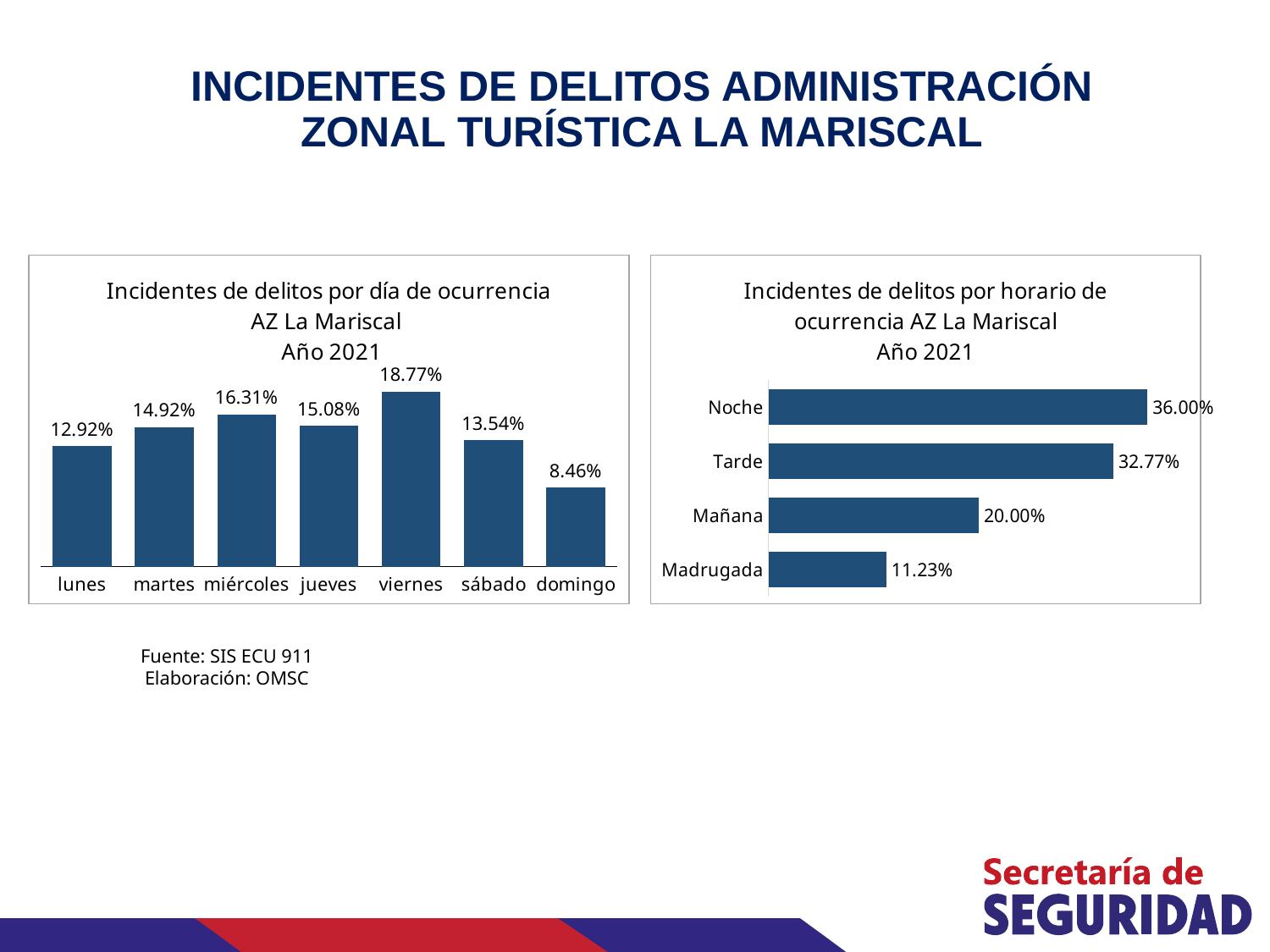
In the right chart (Incidentes de delitos por horario de ocurrencia), which time period has the highest value? Noche What kind of chart is the right chart (Incidentes de delitos por horario de ocurrencia)? bar chart In the left chart (Incidentes de delitos por día de ocurrencia), how many days are shown? 7 In the right chart (Incidentes de delitos por horario de ocurrencia), which time period has the lowest value? Madrugada In the right chart (Incidentes de delitos por horario de ocurrencia), what is the difference between Noche and Mañana? 16.00% In the left chart (Incidentes de delitos por día de ocurrencia), what is the difference between viernes and domingo? 10.31% In the left chart (Incidentes de delitos por día de ocurrencia), what is the value for viernes? 18.77% In the left chart (Incidentes de delitos por día de ocurrencia), which is larger, martes or jueves? jueves In the left chart (Incidentes de delitos por día de ocurrencia), which day has the highest value? viernes In the right chart (Incidentes de delitos por horario de ocurrencia), what is the value for Tarde? 32.77% In the right chart (Incidentes de delitos por horario de ocurrencia), how many time periods are shown? 4 In the left chart (Incidentes de delitos por día de ocurrencia), which day has the lowest value? domingo